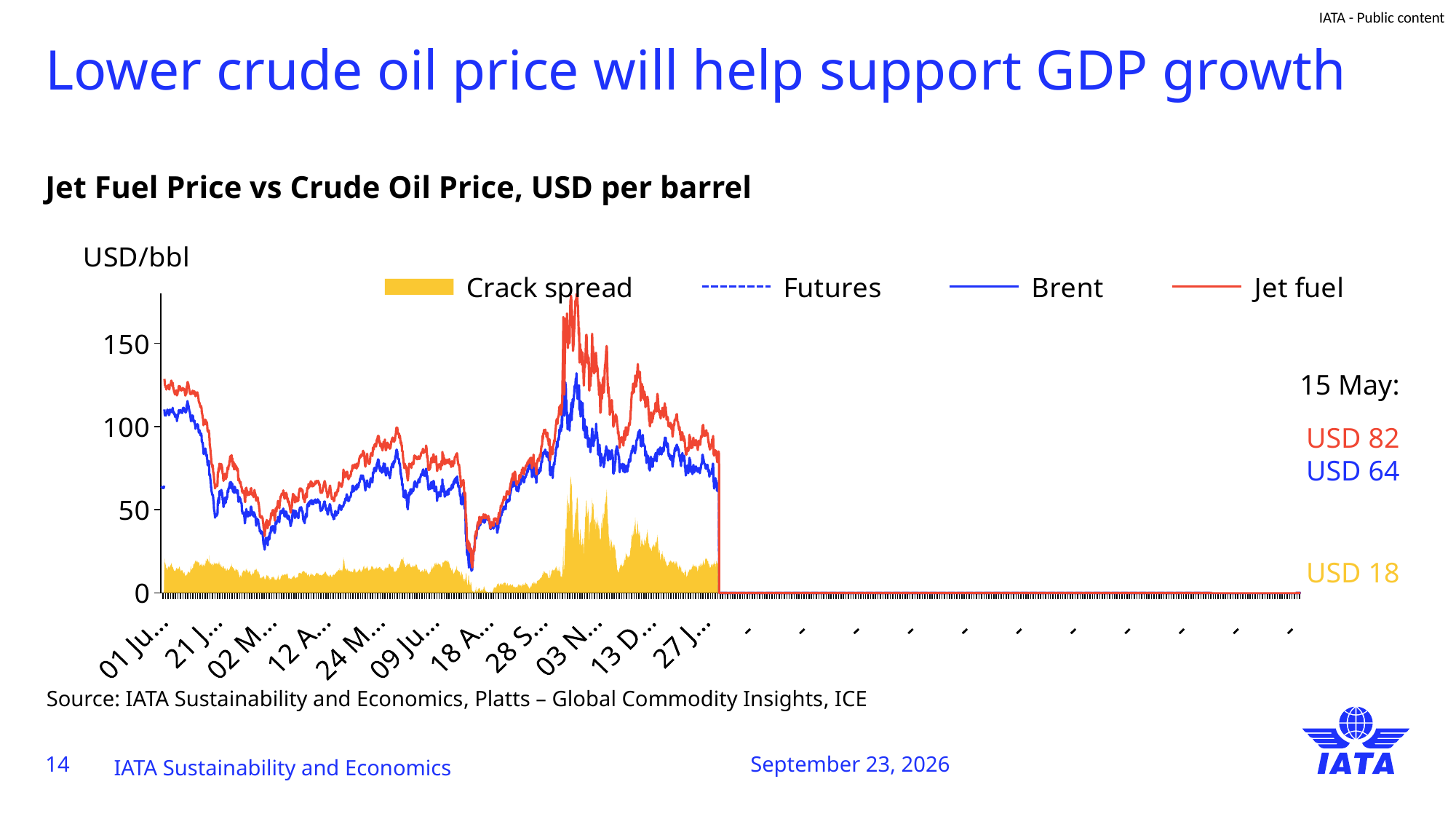
What is the Brent price shown for 15 May? USD 64 What kind of chart is shown on the slide? Line chart What is the crack spread value shown for 15 May? USD 18 Which series has the highest value on 15 May? Jet fuel What is the difference between the jet fuel price and the Brent price on 15 May? USD 18 What is the jet fuel price shown for 15 May? USD 82 On 15 May, which is higher, the jet fuel price or the Brent price? Jet fuel Is the peak value of the jet fuel line greater or less than 150? greater Is the lowest value of the Brent line greater or less than 50? less What is the title of the chart? Jet Fuel Price vs Crude Oil Price, USD per barrel What is the label on the vertical axis of the chart? USD/bbl How many series does the legend list? 4